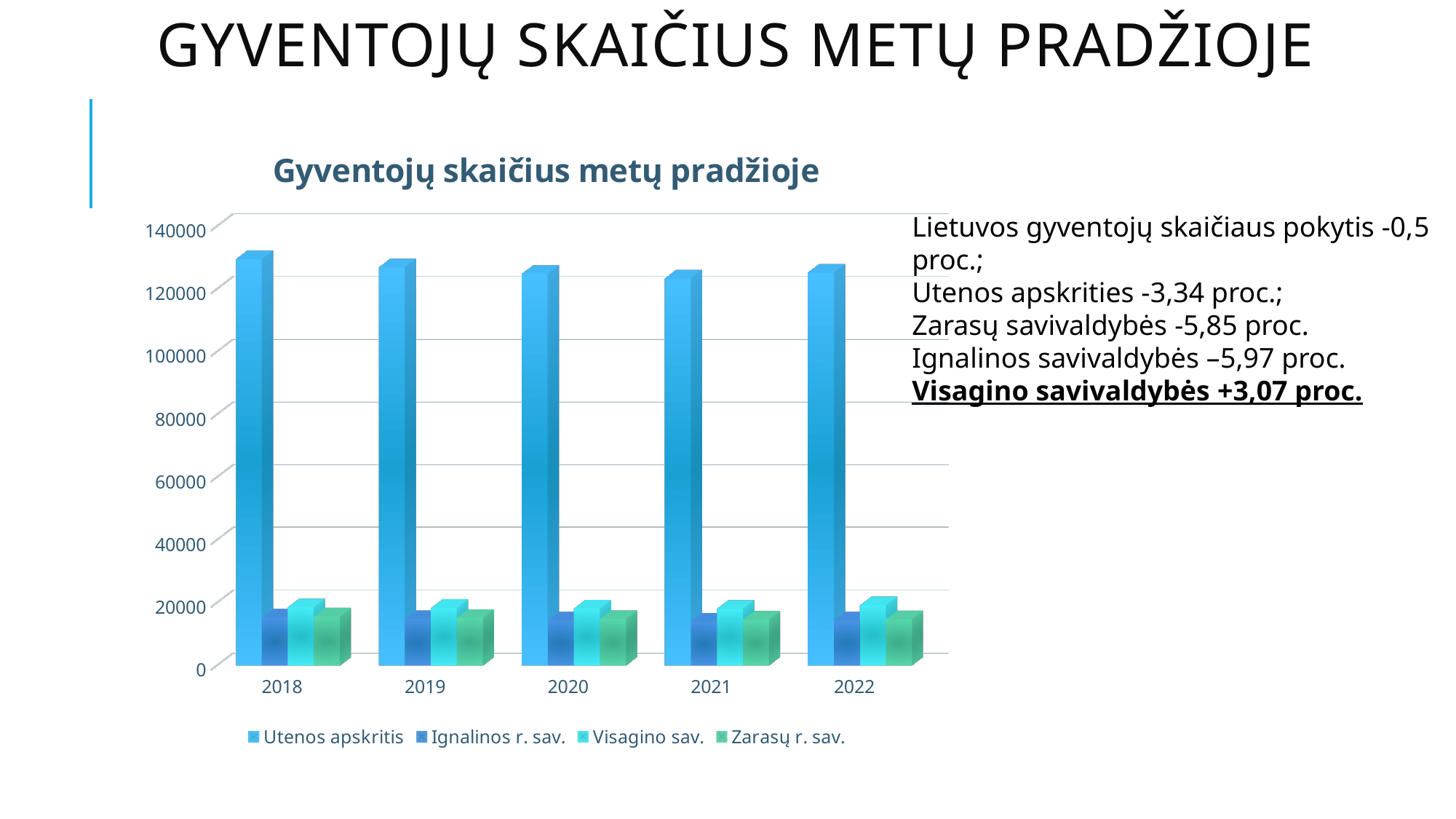
How many series does the chart legend list? 4 How many years are shown on the x axis of the chart? 5 Is the value for Ignalinos r. sav. in 2018 greater or less than 20000? less Does the value for Utenos apskritis rise or fall from 2018 to 2020? fall Which series is listed last in the chart legend? Zarasų r. sav. Is the value for Utenos apskritis in 2018 greater or less than 120000? greater Which is larger in 2022: the value for Visagino sav. or the value for Ignalinos r. sav.? Visagino sav. What is the title of the chart? Gyventojų skaičius metų pradžioje Is the value for Visagino sav. in 2022 greater or less than 40000? less What kind of chart is shown on the slide? bar chart Which series has the highest value in 2018? Utenos apskritis